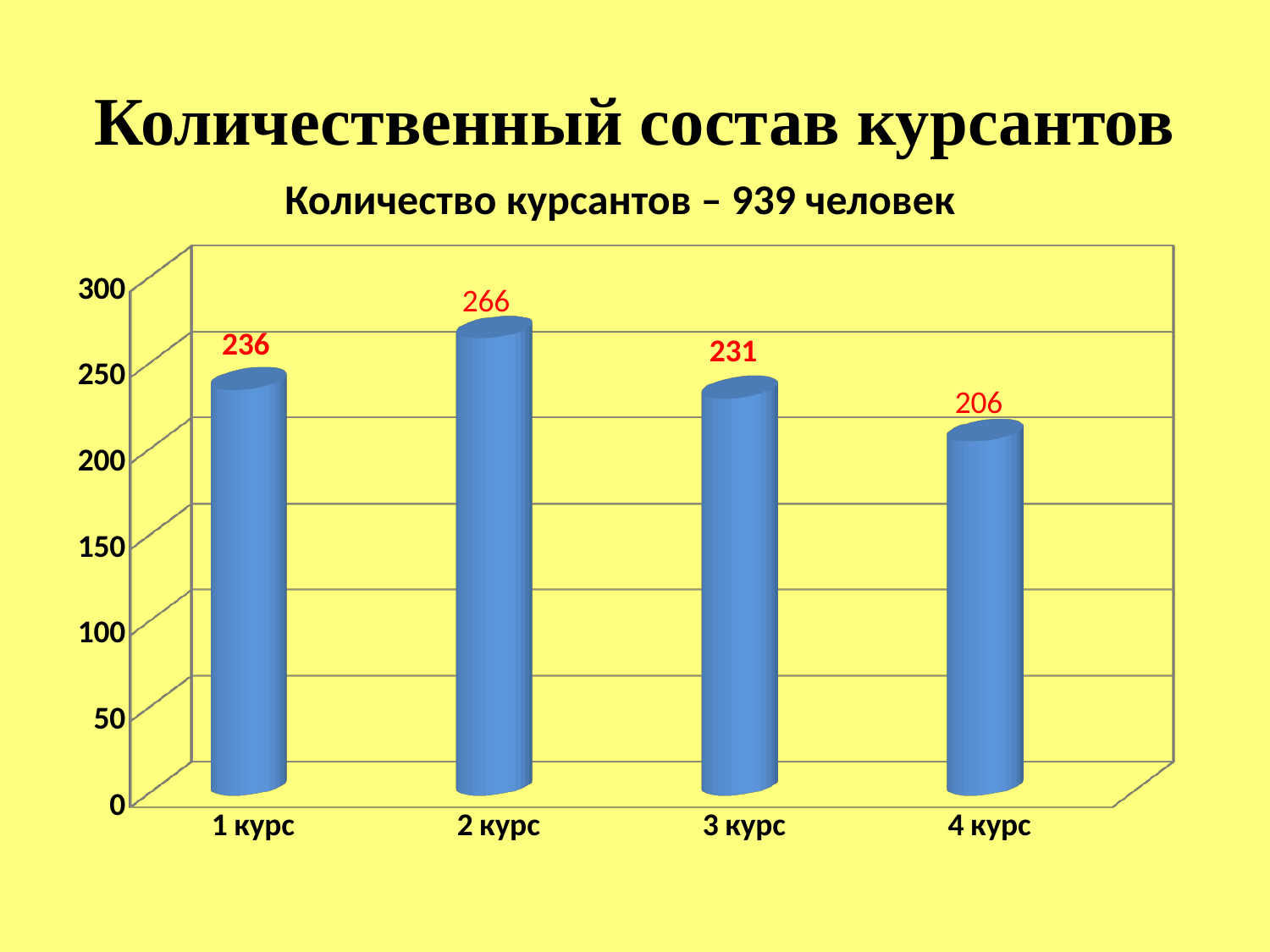
What is the difference between the values for 1 курс and 3 курс? 5 Which course has the highest number of cadets? 2 курс What kind of chart is shown on the slide? bar chart What is the value for 3 курс? 231 What is the value for 4 курс? 206 Which course has the lowest number of cadets? 4 курс What is the difference between the values for 2 курс and 4 курс? 60 Which is larger, the value for 1 курс or the value for 4 курс? 1 курс What is the chart's title? Количество курсантов – 939 человек How many categories are shown on the x axis? 4 What is the value for 2 курс? 266 What is the value for 1 курс? 236